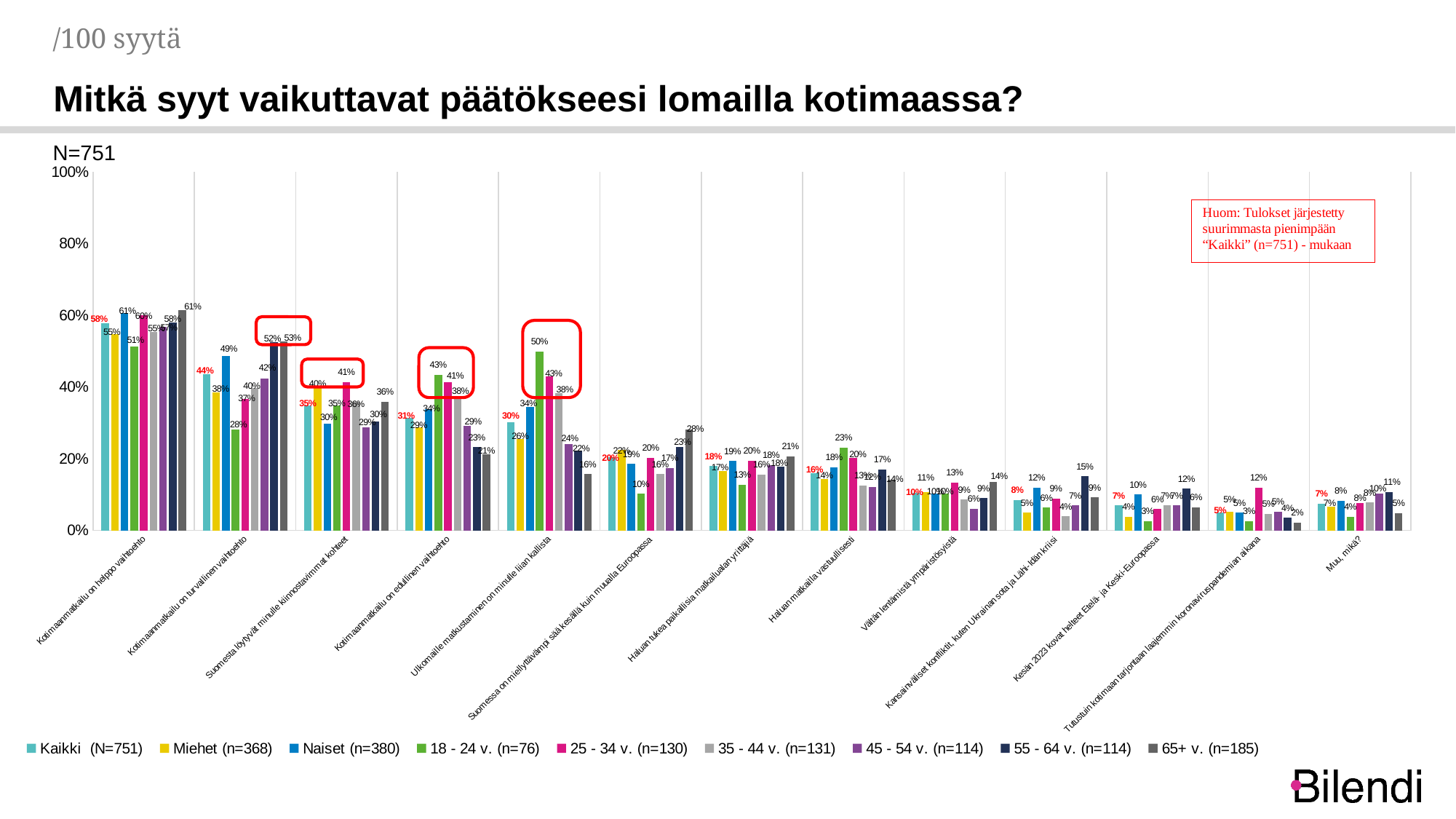
What is the value for 65+ v. (n=185) for "Suomessa on miellyttävämpi sää kesällä kuin muualla Euroopassa"? 28% What is the value for 18 - 24 v. (n=76) for "Ulkomaille matkustaminen on minulle liian kallista"? 50% What is the value for Kaikki (N=751) for "Kotimaanmatkailu on helppo vaihtoehto"? 58% Which category has the highest value for Kaikki (N=751)? Kotimaanmatkailu on helppo vaihtoehto What kind of chart is shown on the slide? Bar chart What is the value for Kaikki (N=751) for "Kotimaanmatkailu on turvallinen vaihtoehto"? 44% What is the difference between the Naiset (n=380) and Miehet (n=368) values for "Kotimaanmatkailu on turvallinen vaihtoehto"? 11% How many categories (reasons) are shown on the x axis? 13 For "Kotimaanmatkailu on edullinen vaihtoehto", which is larger: the value for 18 - 24 v. (n=76) or for 65+ v. (n=185)? 18 - 24 v. (n=76) How many series does the legend list? 9 Is the value for Kaikki (N=751) for "Haluan matkailla vastuullisesti" greater or less than 20%? less Which category has the lowest value for Kaikki (N=751)? Tutustuin kotimaan tarjontaan laajemmin koronaviruspandemian aikana